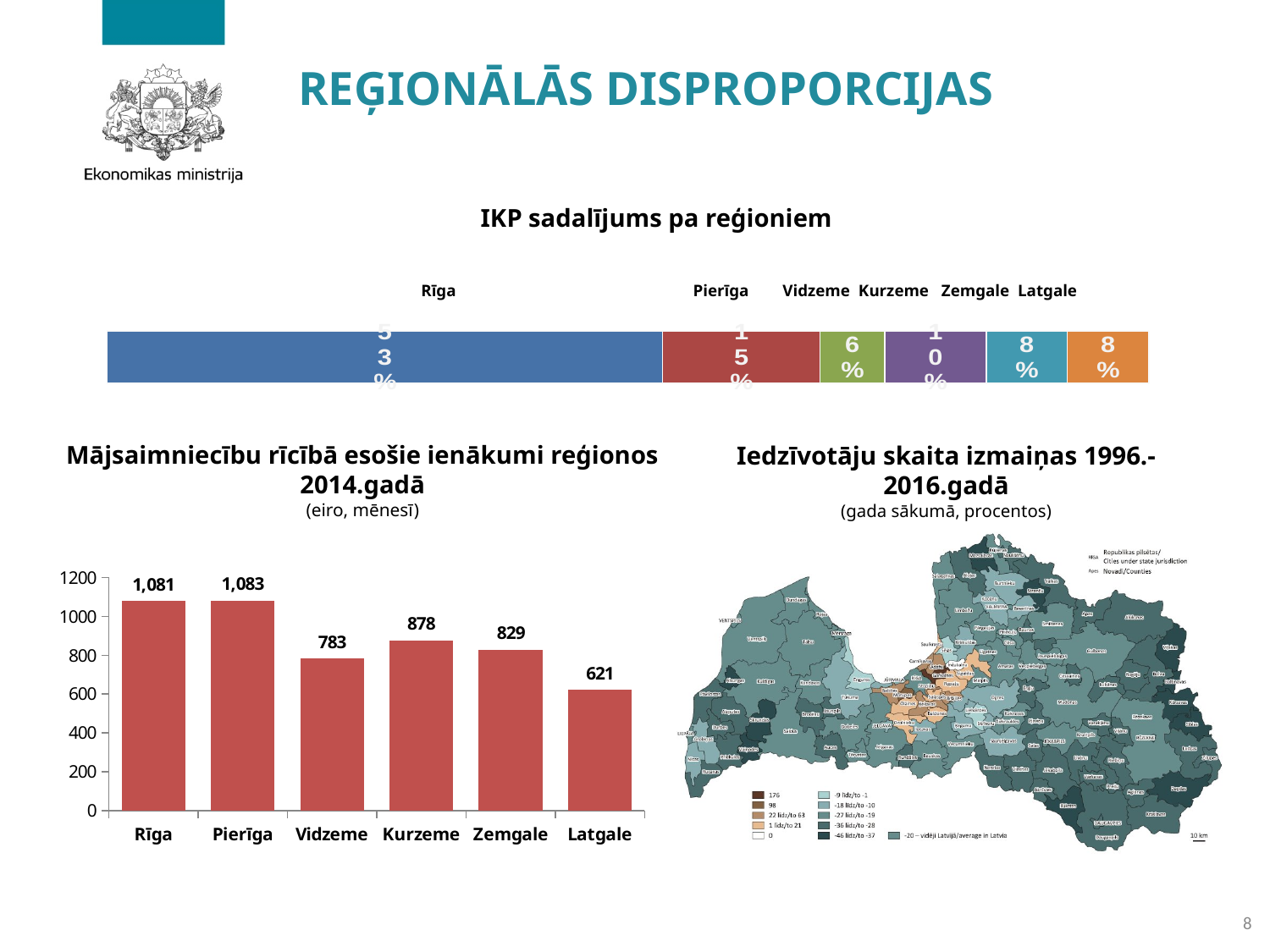
In the 'Mājsaimniecību rīcībā esošie ienākumi reģionos 2014.gadā' chart, what is the difference between Kurzeme and Zemgale? 49 What unit is given in the subtitle of the 'Mājsaimniecību rīcībā esošie ienākumi reģionos 2014.gadā' chart? eiro, mēnesī In the 'Mājsaimniecību rīcībā esošie ienākumi reģionos 2014.gadā' chart, which region has the lowest value? Latgale In the 'Mājsaimniecību rīcībā esošie ienākumi reģionos 2014.gadā' chart, which is larger, Kurzeme or Vidzeme? Kurzeme In the 'Mājsaimniecību rīcībā esošie ienākumi reģionos 2014.gadā' chart, what is the value for Vidzeme? 783 In the 'Mājsaimniecību rīcībā esošie ienākumi reģionos 2014.gadā' chart, how many regions are shown? 6 In the 'IKP sadalījums pa reģioniem' chart, which region has the smallest share? Vidzeme In the 'Mājsaimniecību rīcībā esošie ienākumi reģionos 2014.gadā' chart, which region has the highest value? Pierīga What kind of chart is 'Mājsaimniecību rīcībā esošie ienākumi reģionos 2014.gadā'? Bar chart In the 'IKP sadalījums pa reģioniem' chart, what share does Pierīga have? 15% In the 'IKP sadalījums pa reģioniem' chart, what share does Rīga have? 53% In the 'Mājsaimniecību rīcībā esošie ienākumi reģionos 2014.gadā' chart, what is the value for Latgale? 621